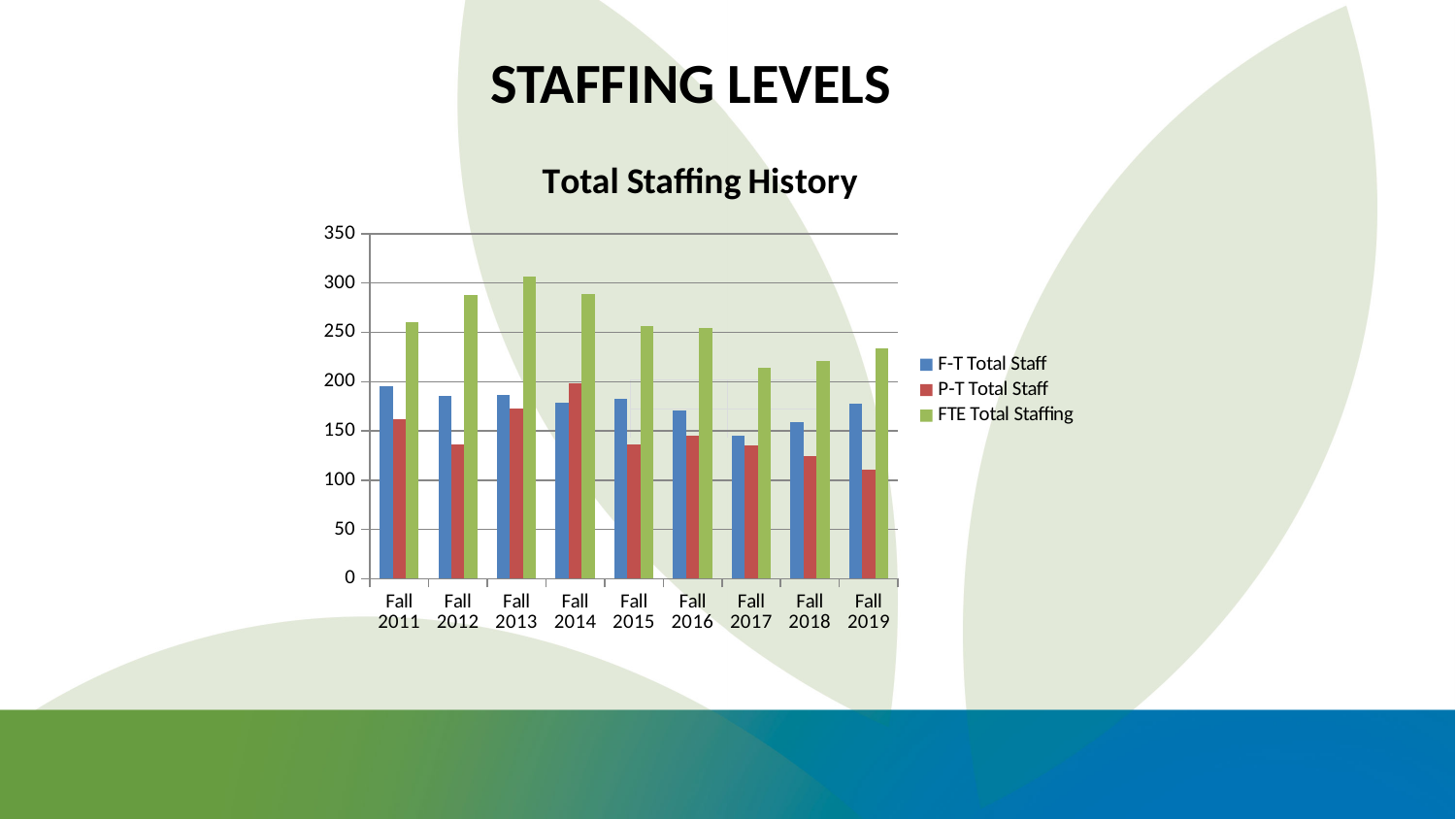
In which Fall term is FTE Total Staffing highest? Fall 2013 Is the FTE Total Staffing value for Fall 2011 greater or less than 250? greater In which Fall term is P-T Total Staff lowest? Fall 2019 What kind of chart is shown on the slide? bar chart In which Fall term is P-T Total Staff highest? Fall 2014 How many Fall terms are shown on the x axis? 9 In which Fall term is F-T Total Staff lowest? Fall 2017 How many series does the legend list? 3 Which is larger in Fall 2014: F-T Total Staff or P-T Total Staff? P-T Total Staff Is the P-T Total Staff value for Fall 2019 greater or less than 150? less Does FTE Total Staffing rise or fall from Fall 2013 to Fall 2017? fall What is the title of the chart? Total Staffing History